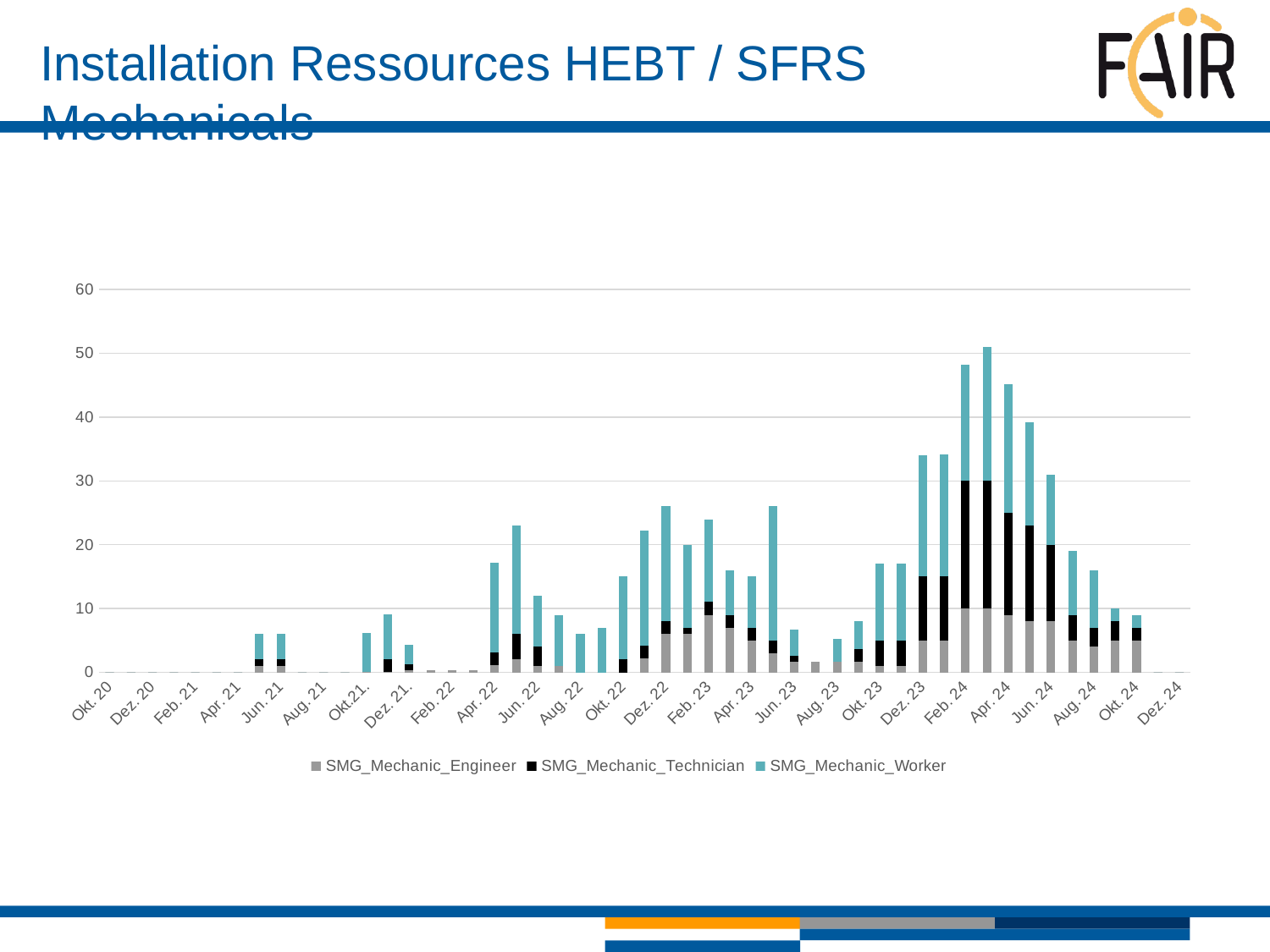
Is the total value for Feb. 24 greater or less than 30? greater Is the total value for Apr. 24 greater or less than 40? greater What is the highest value shown on the vertical axis? 60 Is the total value for Aug. 23 greater or less than 10? less Which series forms the top segment of each stacked bar? SMG_Mechanic_Worker Do the total values rise or fall from Apr. 24 to Okt. 24? fall What kind of chart is shown on the slide? stacked bar chart How many series does the legend list? 3 Which series is shown in black in the legend? SMG_Mechanic_Technician Which has the larger total value, Apr. 24 or Okt. 24? Apr. 24